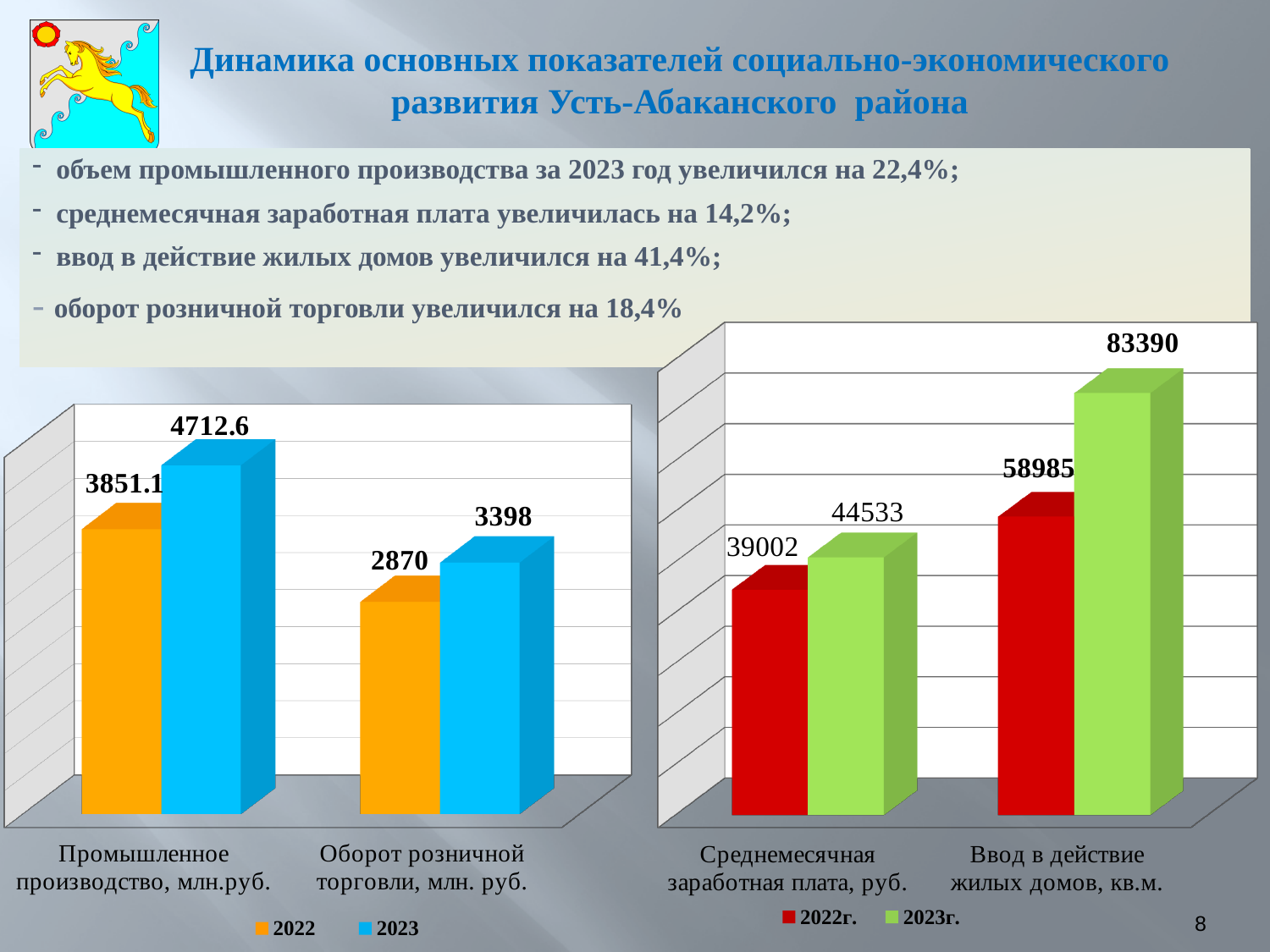
On the left chart, what is the 2023 value for Промышленное производство, млн.руб.? 4712.6 On the left chart, which is larger: the 2023 value for Оборот розничной торговли or the 2022 value for Промышленное производство? 2022 value for Промышленное производство On the right chart, what is the difference between the 2023г. and 2022г. values for Ввод в действие жилых домов, кв.м.? 24405 On the right chart, what is the 2022г. value for Среднемесячная заработная плата, руб.? 39002 What type of chart is the left chart? Bar chart On the left chart, what is the difference between the 2023 and 2022 values for Промышленное производство, млн.руб.? 861.5 On the right chart, which bar is the highest? 2023г. Ввод в действие жилых домов, кв.м. On the right chart, what is the 2023г. value for Ввод в действие жилых домов, кв.м.? 83390 On the left chart, what is the 2022 value for Оборот розничной торговли, млн. руб.? 2870 How many series does the legend of the right chart list? 2 On the left chart, which bar is the lowest? 2022 Оборот розничной торговли, млн. руб. On the right chart, what is the difference between the 2023г. and 2022г. values for Среднемесячная заработная плата, руб.? 5531